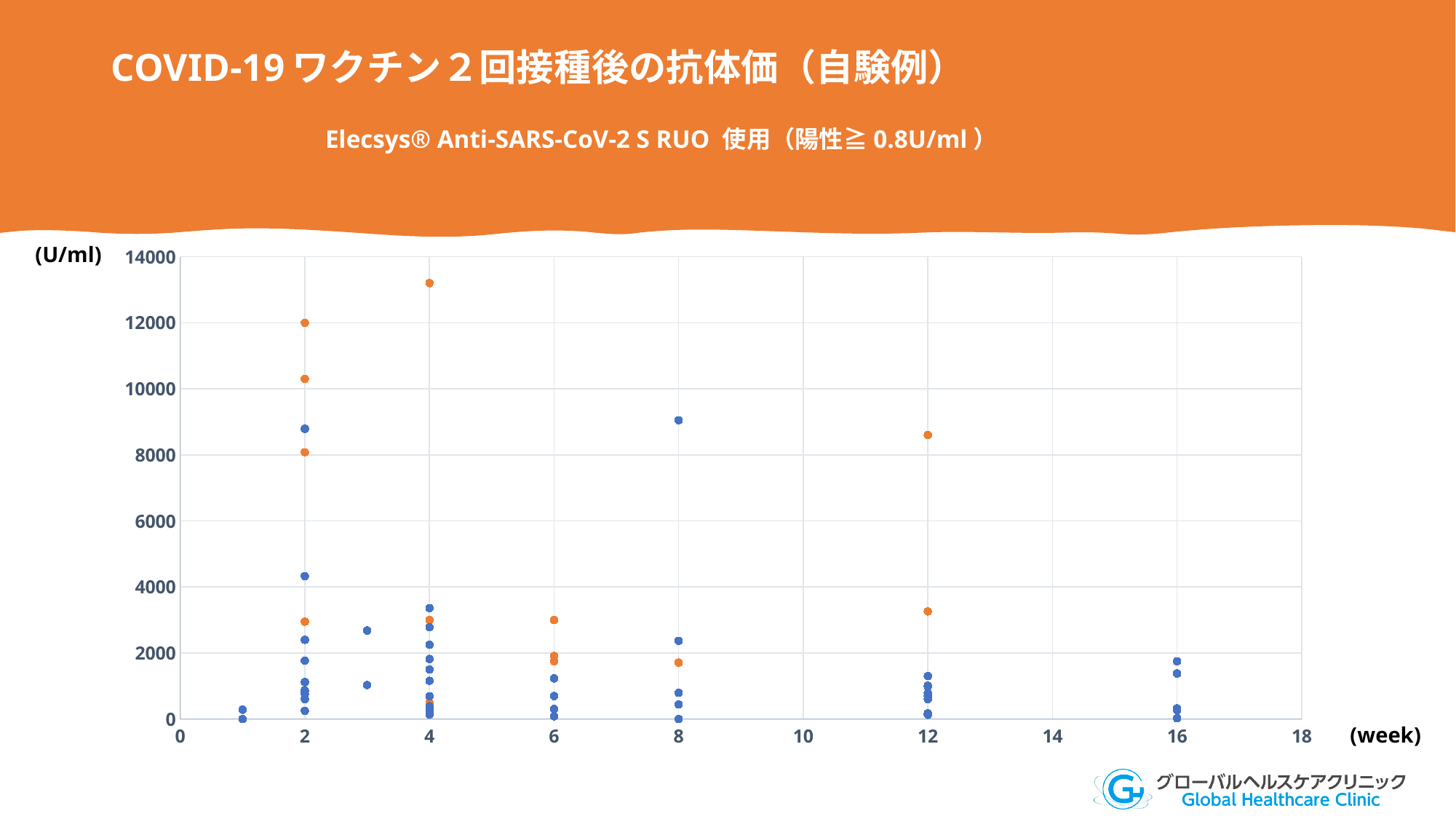
Is the highest orange point at week 12 greater or less than 8000? greater Is the highest blue point at week 8 greater or less than 8000? greater Is the highest point at week 16 greater or less than 2000? less At which week does the highest point on the chart appear? 4 What kind of chart is shown on the slide? scatter chart What unit is shown on the vertical axis of the chart? U/ml What is the maximum value shown on the vertical axis? 14000 Which is larger: the highest point at week 4 or the highest point at week 12? week 4 What unit is shown on the horizontal axis of the chart? week